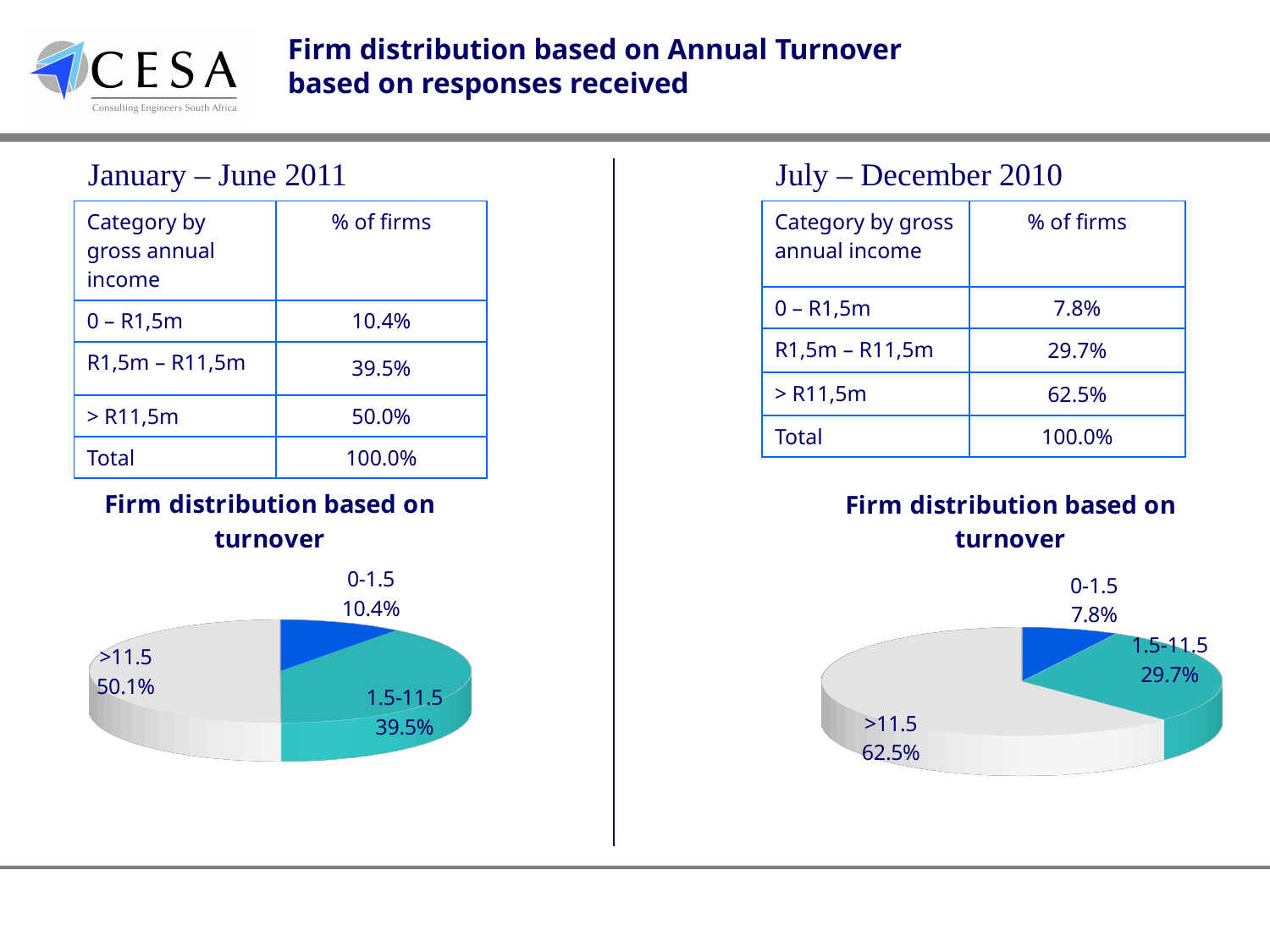
How many slices does the left pie chart (January – June 2011) have? 3 In the right pie chart (July – December 2010), what share is shown for the 0-1.5 slice? 7.8% In the left pie chart (January – June 2011), what share is shown for the 0-1.5 slice? 10.4% In the right pie chart (July – December 2010), which category has the largest slice? >11.5 What type of chart is used on the right side of the slide for July – December 2010? Pie chart In the right pie chart (July – December 2010), what share is shown for the 1.5-11.5 slice? 29.7% In the left pie chart (January – June 2011), what share is shown for the 1.5-11.5 slice? 39.5% In the right pie chart (July – December 2010), what is the difference between the >11.5 slice and the 1.5-11.5 slice? 32.8% In the left pie chart (January – June 2011), which category has the smallest slice? 0-1.5 In the left pie chart (January – June 2011), which slice is larger: 1.5-11.5 or 0-1.5? 1.5-11.5 In the right pie chart (July – December 2010), what share is shown for the >11.5 slice? 62.5% In the left pie chart (January – June 2011), what share is shown for the >11.5 slice? 50.1%